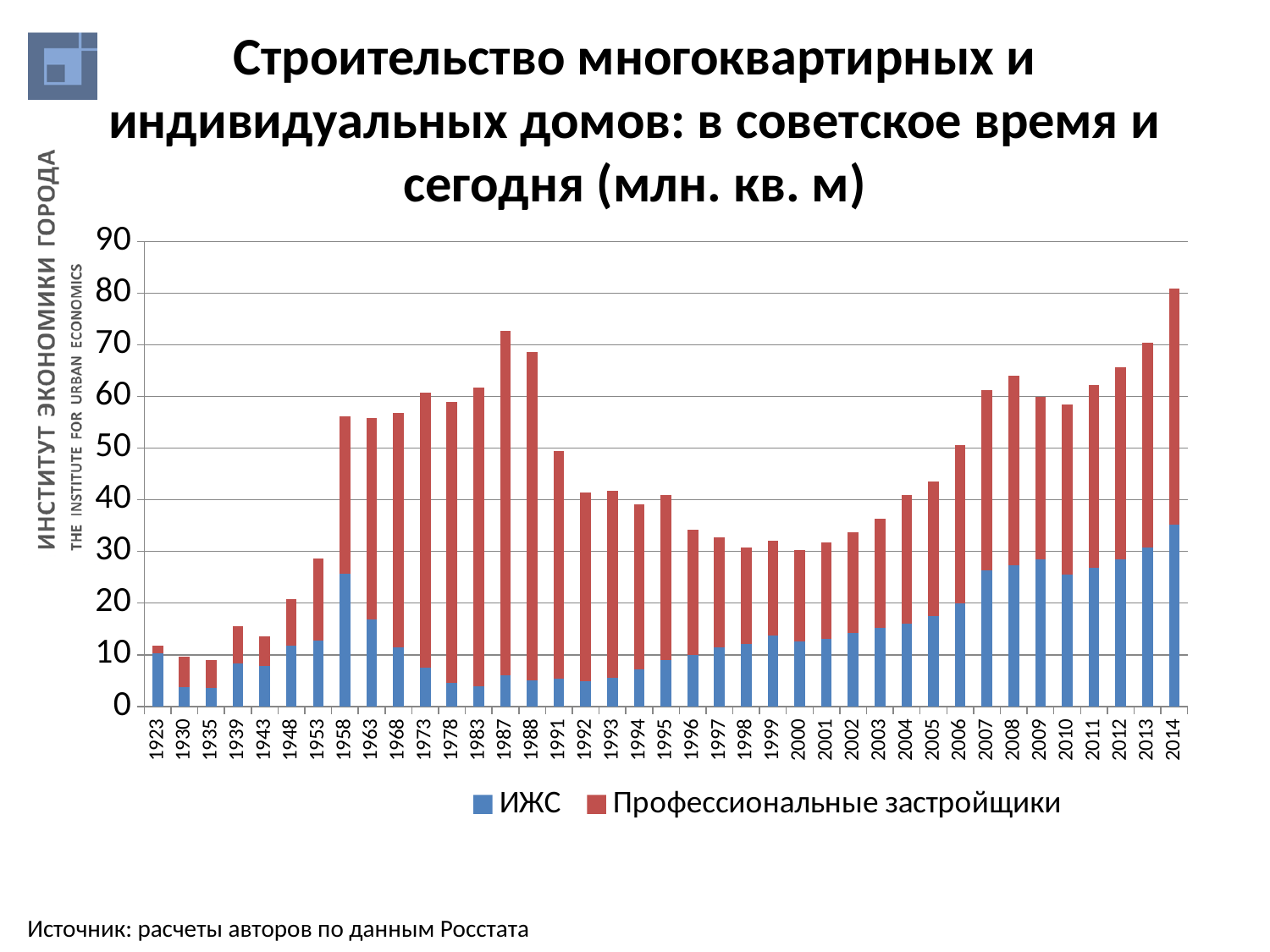
Which year has the highest total bar? 2014 Which year has the larger total bar, 1987 or 1988? 1987 Which year has the lowest total bar? 1935 Do the total bars generally rise or fall from 2000 to 2014? rise How many years are shown on the x axis? 39 How many series does the legend list? 2 Is the total value for 2000 greater or less than 40? less What are the two series named in the legend? ИЖС and Профессиональные застройщики Is the total value for 1958 greater or less than 50? greater What kind of chart is shown on the slide? Stacked bar chart Which year has the larger total bar, 2013 or 2014? 2014 Is the total value for 2014 greater or less than 70? greater